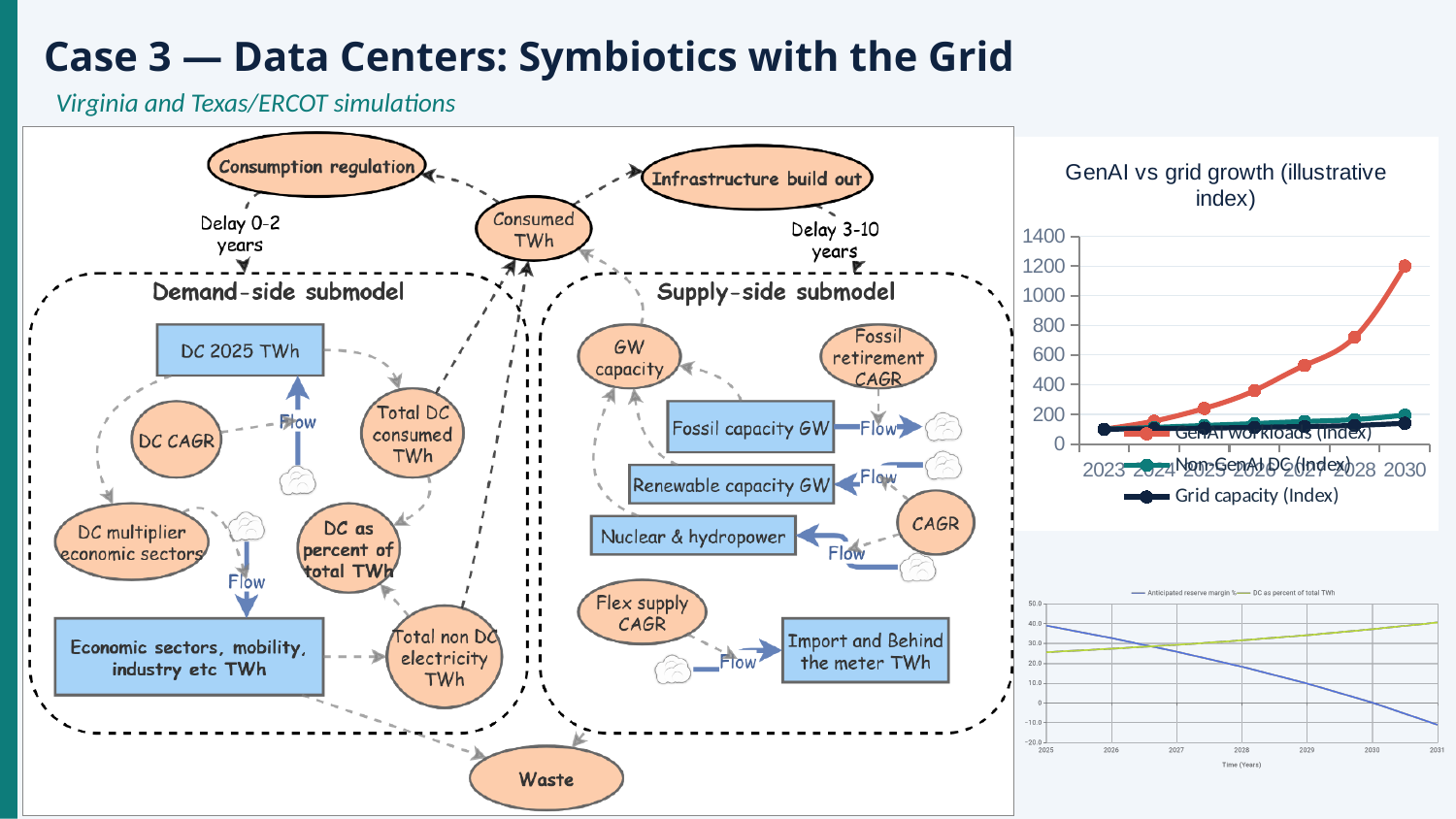
In the small chart at the bottom right, does the 'Anticipated reserve margin %' series rise or fall over time? fall In the 'GenAI vs grid growth (illustrative index)' chart, is the value for Grid capacity (Index) in 2030 greater or less than 400? less How many years are shown on the x axis of the 'GenAI vs grid growth (illustrative index)' chart? 7 In the 'GenAI vs grid growth (illustrative index)' chart, does the GenAI workloads (Index) series rise or fall from 2023 to 2030? rise In the 'GenAI vs grid growth (illustrative index)' chart, is the value for GenAI workloads (Index) in 2030 greater or less than 1000? greater What type of chart is the 'GenAI vs grid growth (illustrative index)' chart? line chart What is the title of the line chart on the right side of the slide? GenAI vs grid growth (illustrative index) In the 'GenAI vs grid growth (illustrative index)' chart, is the value for GenAI workloads (Index) in 2028 greater or less than 400? greater How many series does the legend of the 'GenAI vs grid growth (illustrative index)' chart list? 3 In the 'GenAI vs grid growth (illustrative index)' chart, which series has the highest value in 2030? GenAI workloads (Index) In the 'GenAI vs grid growth (illustrative index)' chart, which is larger in 2030: GenAI workloads (Index) or Grid capacity (Index)? GenAI workloads (Index)